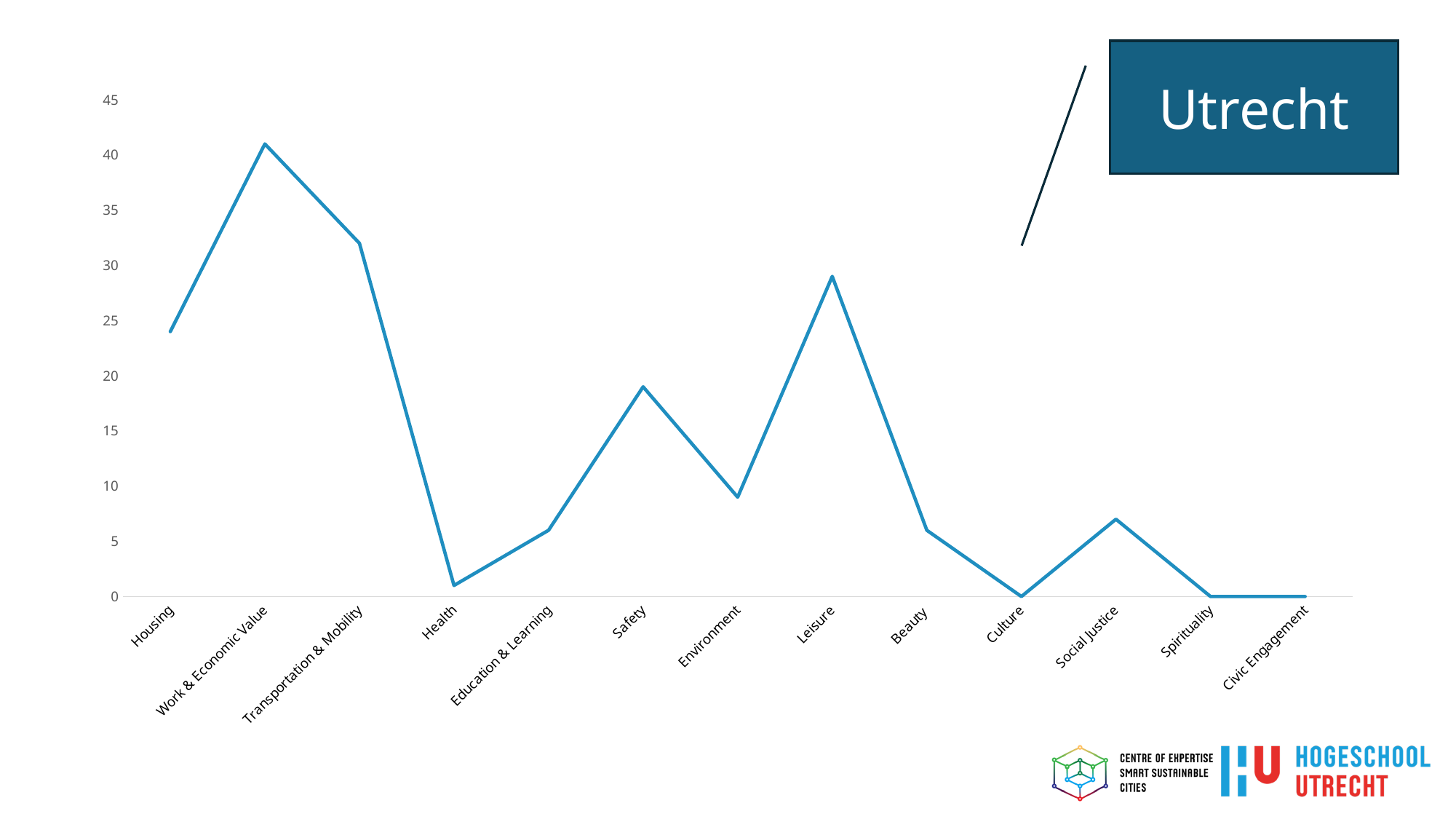
Which category has the highest value? Work & Economic Value Is the value for Housing greater or less than 20? greater Does the line rise or fall between Transportation & Mobility and Health? fall How many categories are plotted along the x axis? 13 Is the value for Safety greater or less than 15? greater What is the value for Civic Engagement? 0 Is the value for Leisure greater or less than 25? greater Which is larger, the value for Leisure or the value for Safety? Leisure What is the value for Culture? 0 What kind of chart is shown on the slide? line chart What title is shown in the box at the top right of the slide? Utrecht